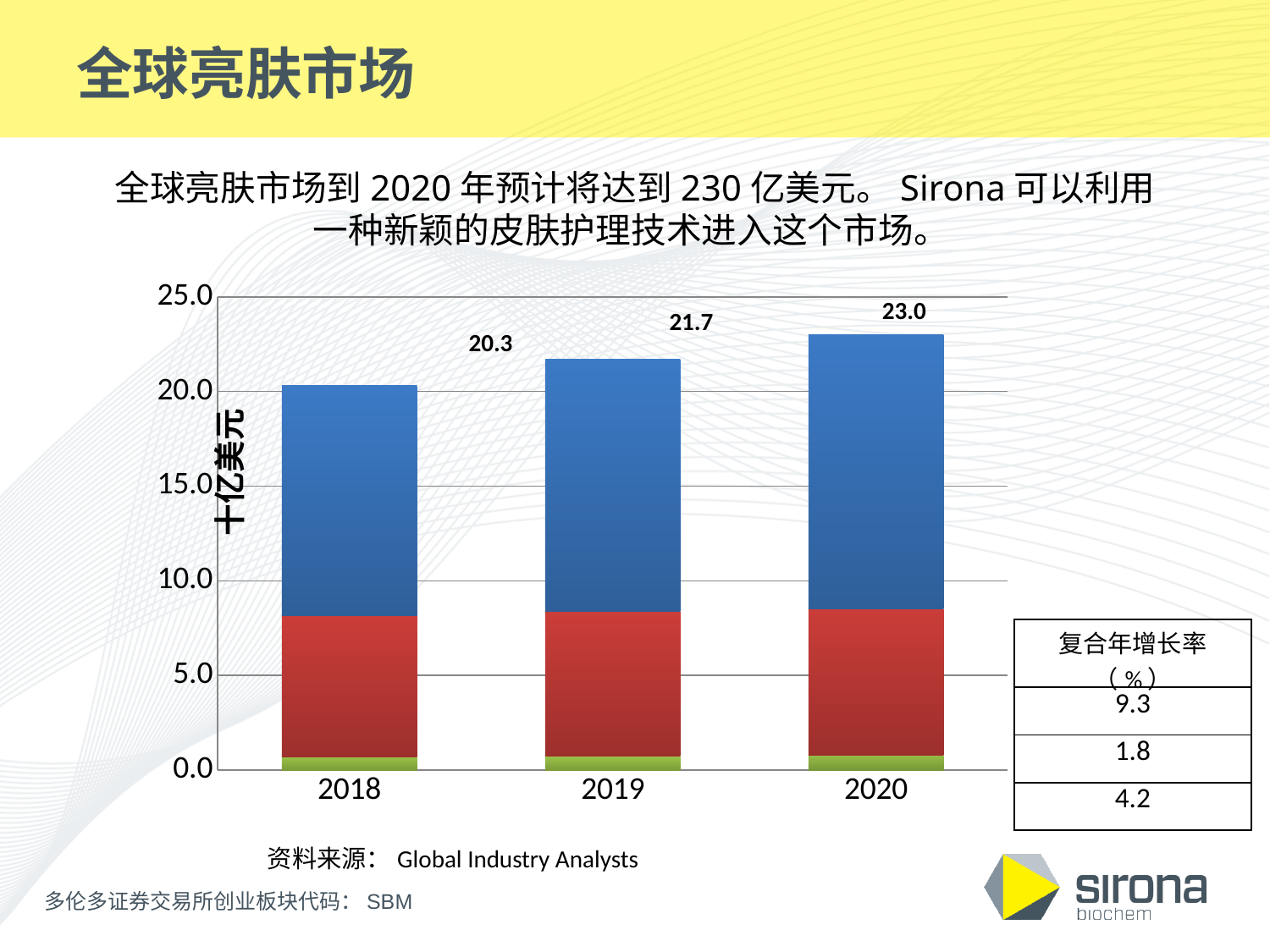
What is the total value labelled on the bar for 2020? 23.0 How many years are shown on the x axis? 3 Which year has the highest total value? 2020 What is the label on the y axis of the chart? 十亿美元 What is the total value labelled on the bar for 2018? 20.3 What is the total value labelled on the bar for 2019? 21.7 Is the top of the red segment in the 2018 bar greater or less than 10.0? less Do the total values rise or fall from 2018 to 2020? Rise Which is larger, the total for 2019 or the total for 2018? 2019 What kind of chart is shown on the slide? Stacked bar chart What is the difference between the total for 2020 and the total for 2018? 2.7 Which year has the lowest total value? 2018